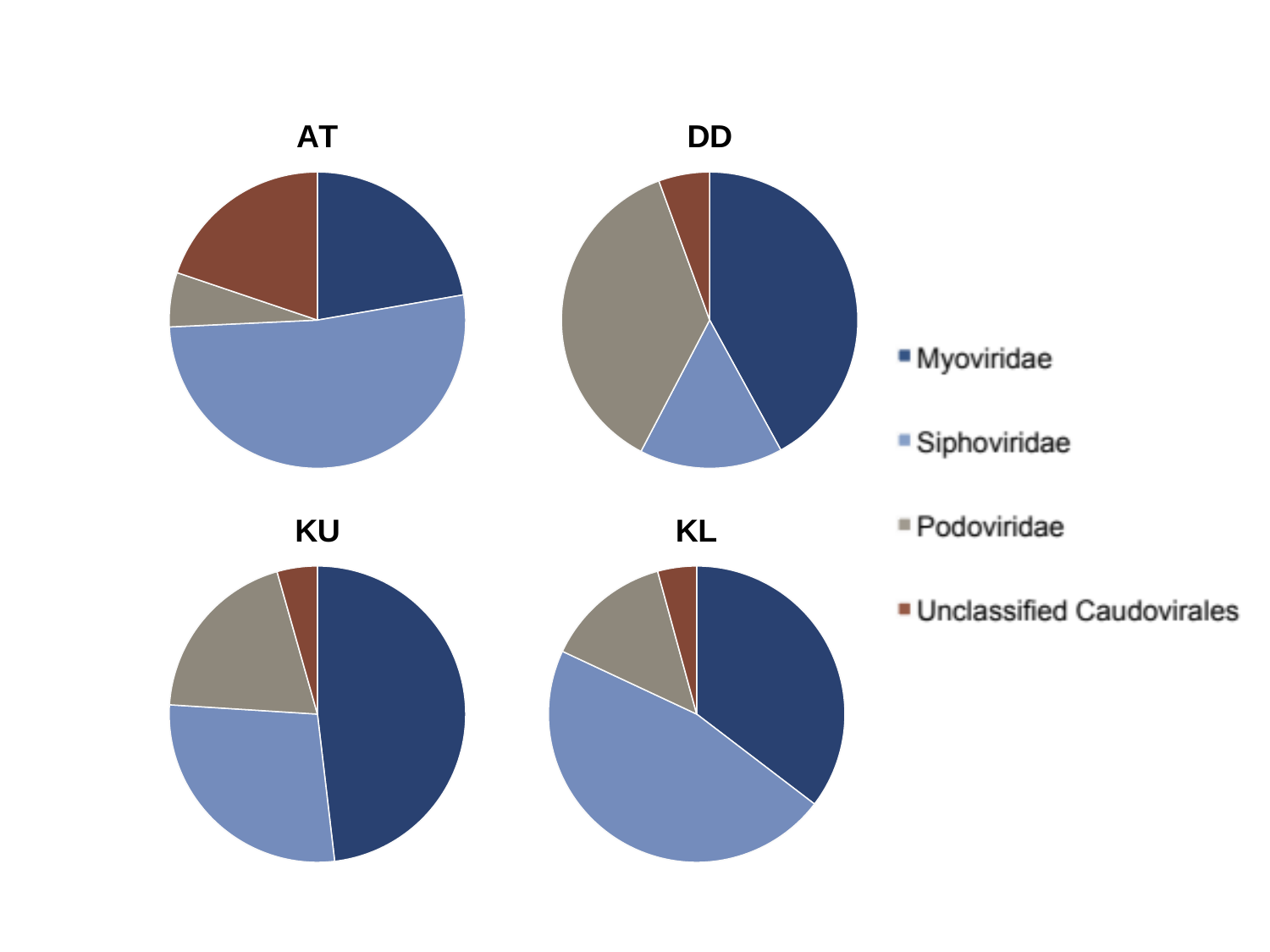
In the DD chart, which slice is larger: Podoviridae or Siphoviridae? Podoviridae In the KL chart, which category has the smallest slice? Unclassified Caudovirales What kind of chart is used for the AT chart? pie chart In the AT chart, which category has the largest slice? Siphoviridae In the AT chart, which category has the smallest slice? Podoviridae How many charts are shown on the slide? 4 How many categories does the legend list? 4 Which colour represents Podoviridae in the legend? grey In the DD chart, which category has the smallest slice? Unclassified Caudovirales In the KL chart, which category has the largest slice? Siphoviridae In the DD chart, which category has the largest slice? Myoviridae